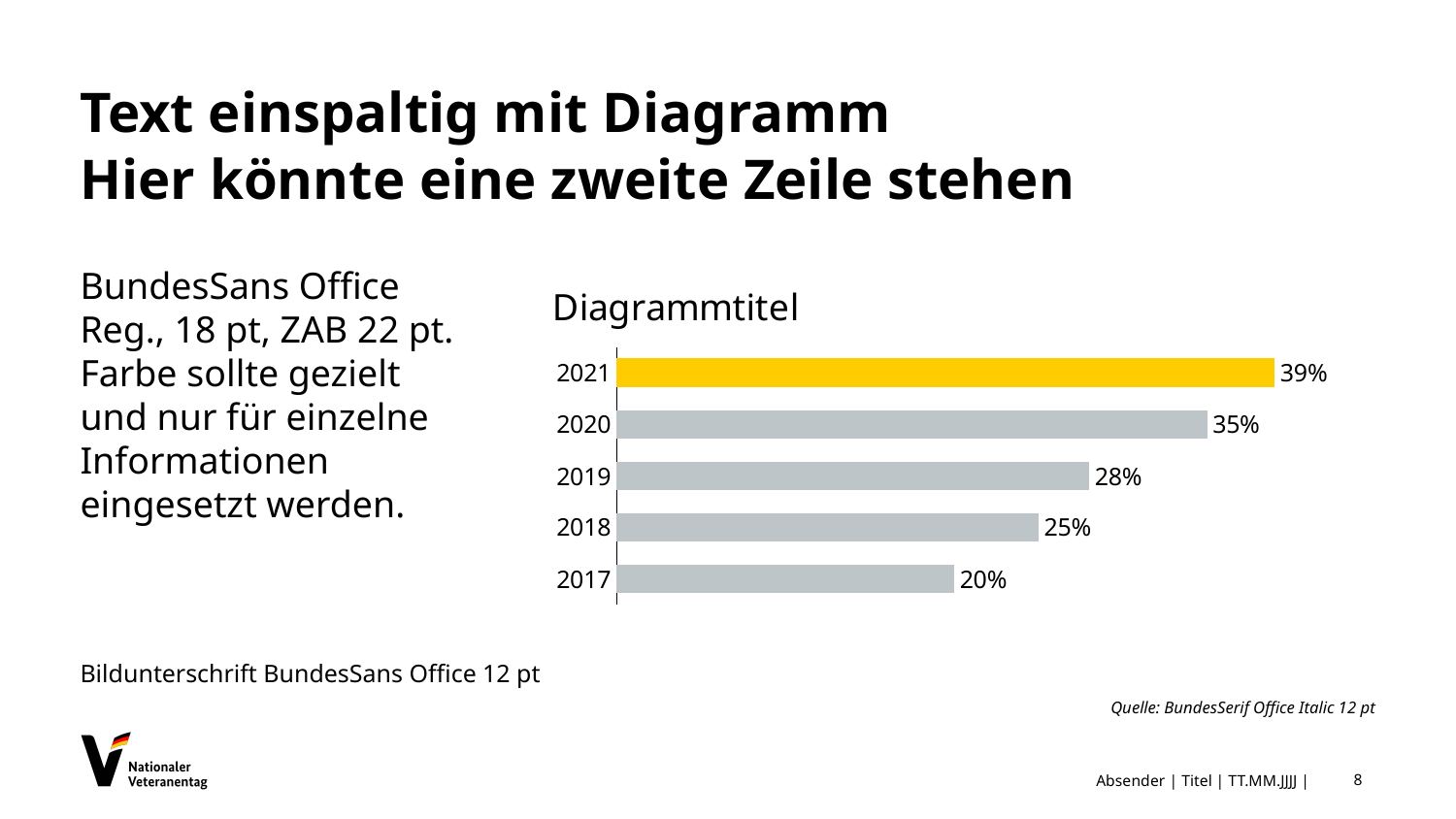
Do the values rise or fall from 2017 to 2021? Rise What is the title of the chart? Diagrammtitel Which is larger, the value for 2018 or the value for 2020? 2020 What is the value for 2017? 20% What is the difference between the values for 2019 and 2017? 8% How many years are shown in the chart? 5 What is the value for 2021? 39% Which year has the highest value? 2021 Which year has the lowest value? 2017 What kind of chart is shown? Bar chart What is the difference between the values for 2021 and 2020? 4% What is the value for 2019? 28%